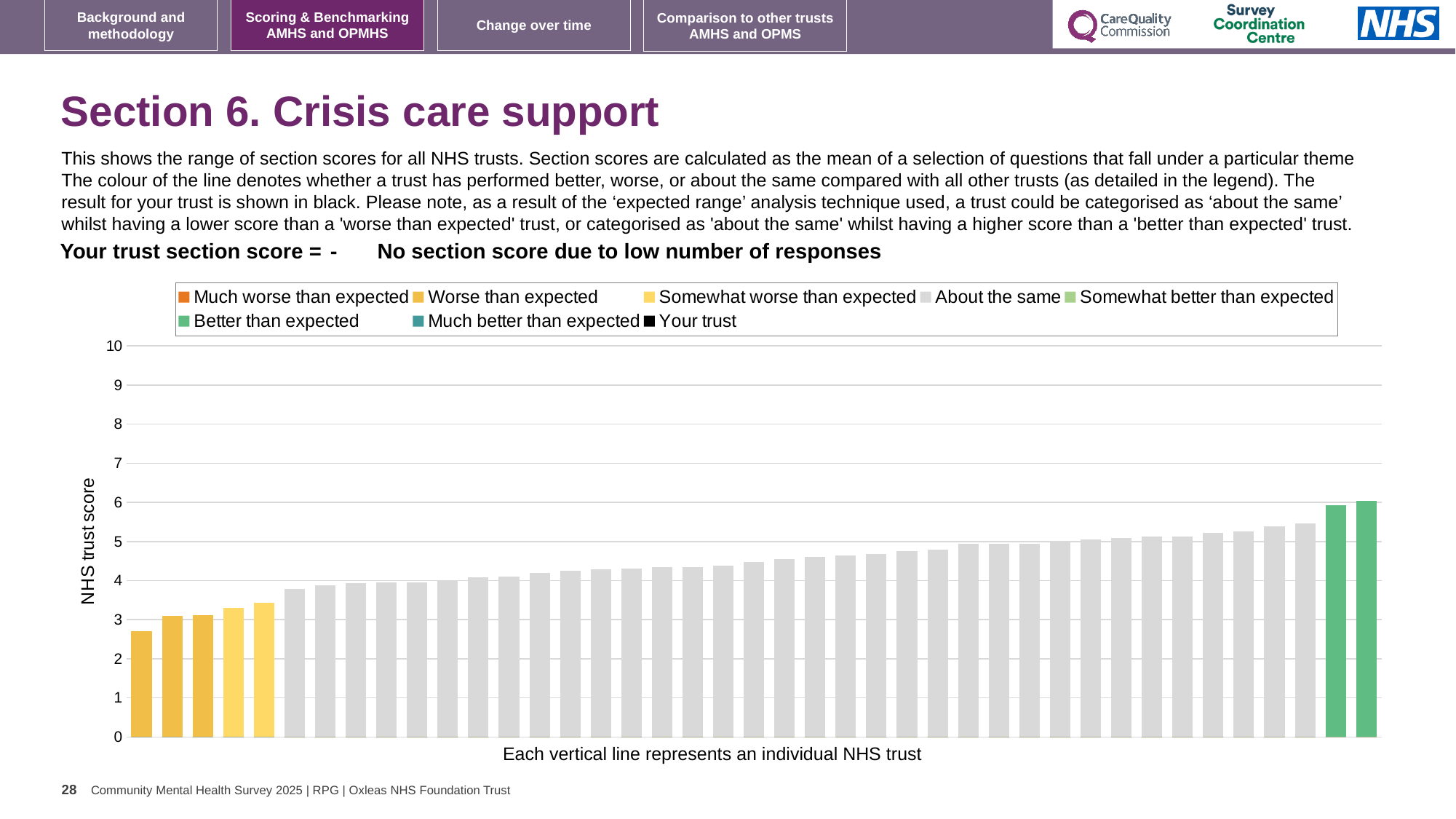
What kind of chart is shown on the slide? bar chart Which bar is taller, the leftmost bar or the rightmost bar? the rightmost bar Is the value of the leftmost bar greater or less than 3? less What is the highest value shown on the vertical axis of the chart? 10 Is the value of the rightmost bar greater or less than 5? greater Is the value of the tallest grey bar greater or less than 6? less Do the bar values rise or fall from left to right across the chart? rise What is the label on the vertical axis of the chart? NHS trust score How many bars are coloured green (better than expected) in the chart? 2 How many entries does the chart's legend list? 8 What does the text below the horizontal axis say each vertical line represents? an individual NHS trust How many bars are coloured in the 'Worse than expected' or 'Somewhat worse than expected' yellow shades in the chart? 5